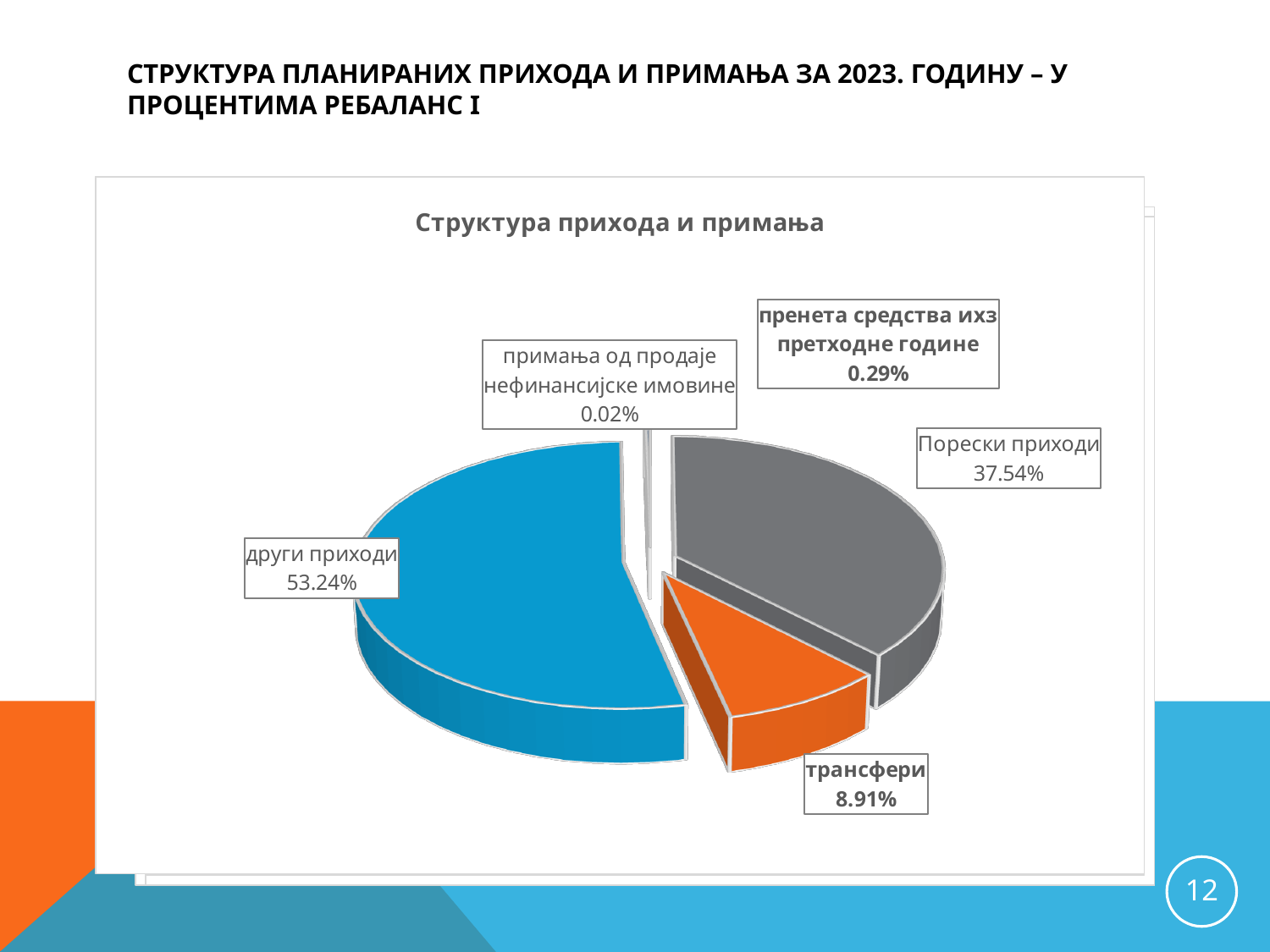
What share of the pie is labelled for "трансфери"? 8.91% How many slices does the pie chart have? 5 Which category has the smallest share of the pie? примања од продаје нефинансијске имовине What share of the pie is labelled for "пренета средства из претходне године"? 0.29% Which is larger, the share for "трансфери" or the share for "пренета средства из претходне године"? трансфери What is the difference in percentage points between "други приходи" and "Порески приходи"? 15.70 What share of the pie is labelled for "Порески приходи"? 37.54% What type of chart is shown on the slide? Pie chart What share of the pie is labelled for "други приходи"? 53.24% Which category has the largest share of the pie? други приходи What share of the pie is labelled for "примања од продаје нефинансијске имовине"? 0.02% What is the chart's title? Структура прихода и примања